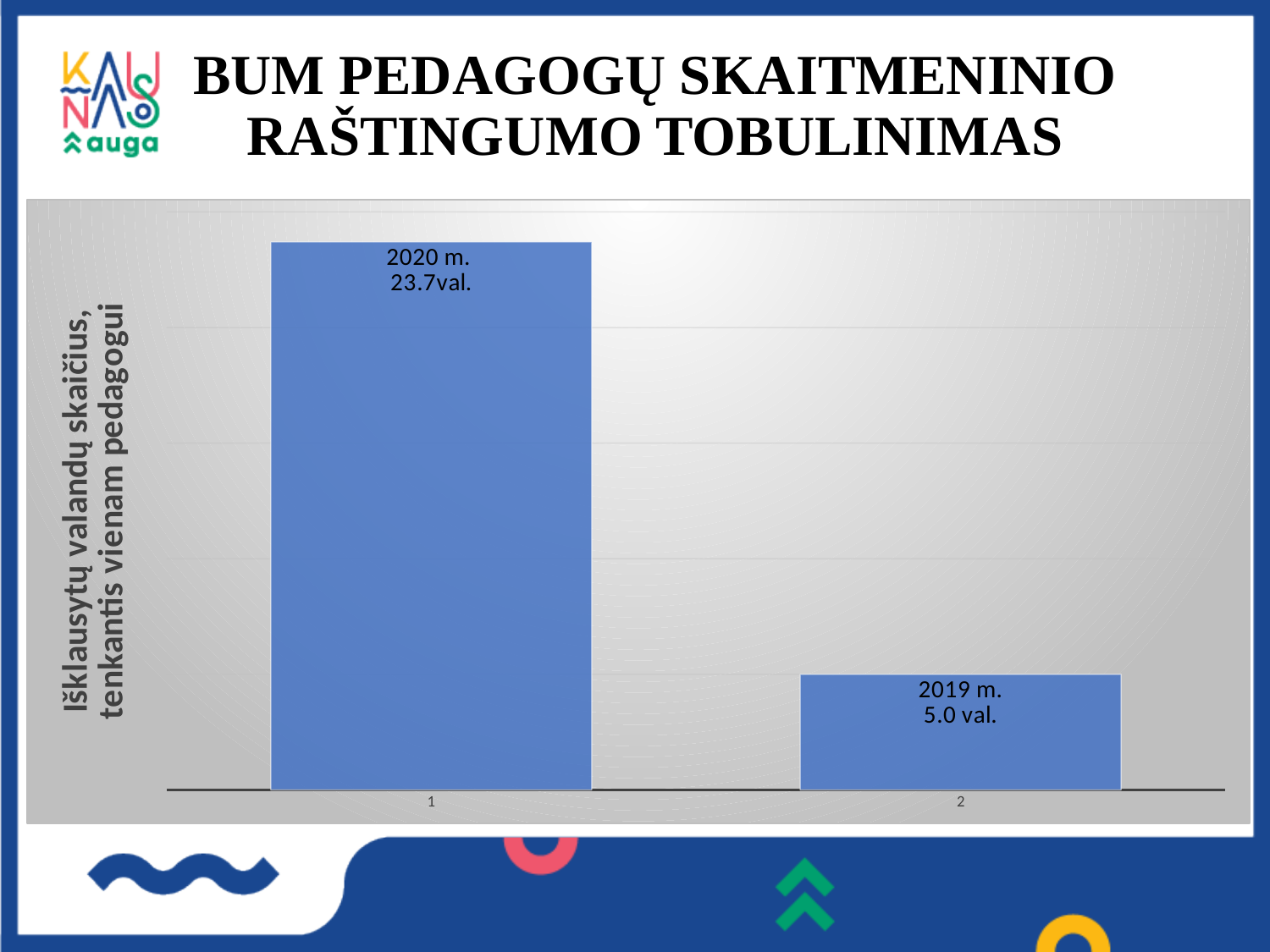
How many bars are plotted in the chart? 2 What type of chart is shown on the slide? bar chart What is the label of the vertical axis of the chart? Išklausytų valandų skaičius, tenkantis vienam pedagogui By how many hours does the 2020 m. value exceed the 2019 m. value? 18.7 val. Is the value for 2020 m. larger or smaller than the value for 2019 m.? larger What value is shown for 2020 m. in the chart? 23.7val. What are the category tick labels shown on the horizontal axis? 1 and 2 What colour are the bars in the chart? blue Which year has the higher number of hours per pedagogue? 2020 m. Which year has the lower number of hours per pedagogue? 2019 m. What value is shown for 2019 m. in the chart? 5.0 val.